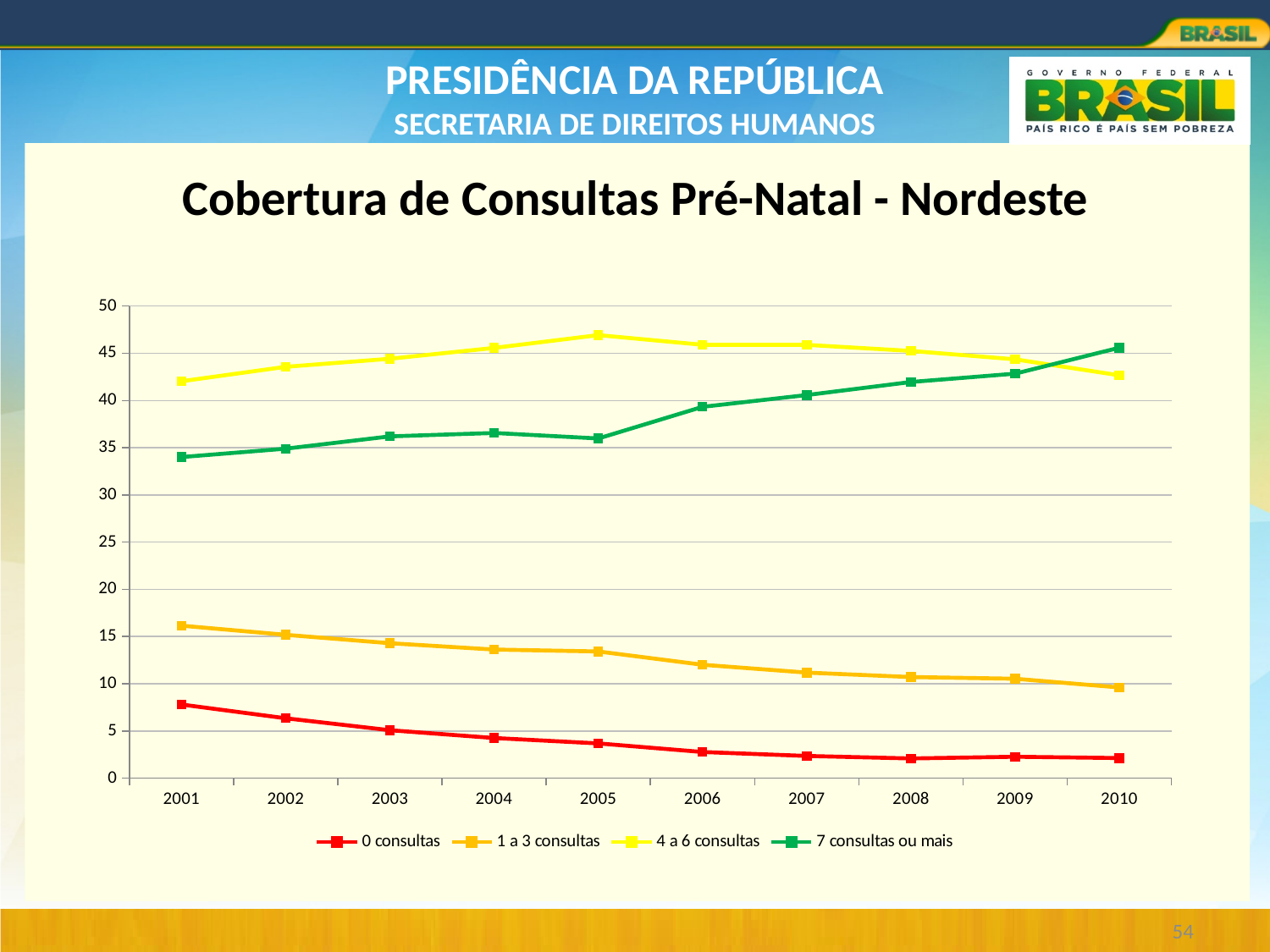
Which series has the lowest value in 2010? 0 consultas How many series does the legend list? 4 Which series has the highest value in 2001? 4 a 6 consultas Does the value for '0 consultas' rise or fall from 2001 to 2010? fall What is the title of the chart? Cobertura de Consultas Pré-Natal - Nordeste Is the value for '0 consultas' in 2001 greater or less than 5? greater Is the value for '4 a 6 consultas' in 2005 greater or less than 45? greater How many years are plotted along the x axis? 10 In 2010, which is larger: '7 consultas ou mais' or '4 a 6 consultas'? 7 consultas ou mais In which year is the value for '4 a 6 consultas' highest? 2005 In which year is the value for '7 consultas ou mais' highest? 2010 What kind of chart is shown on the slide? line chart